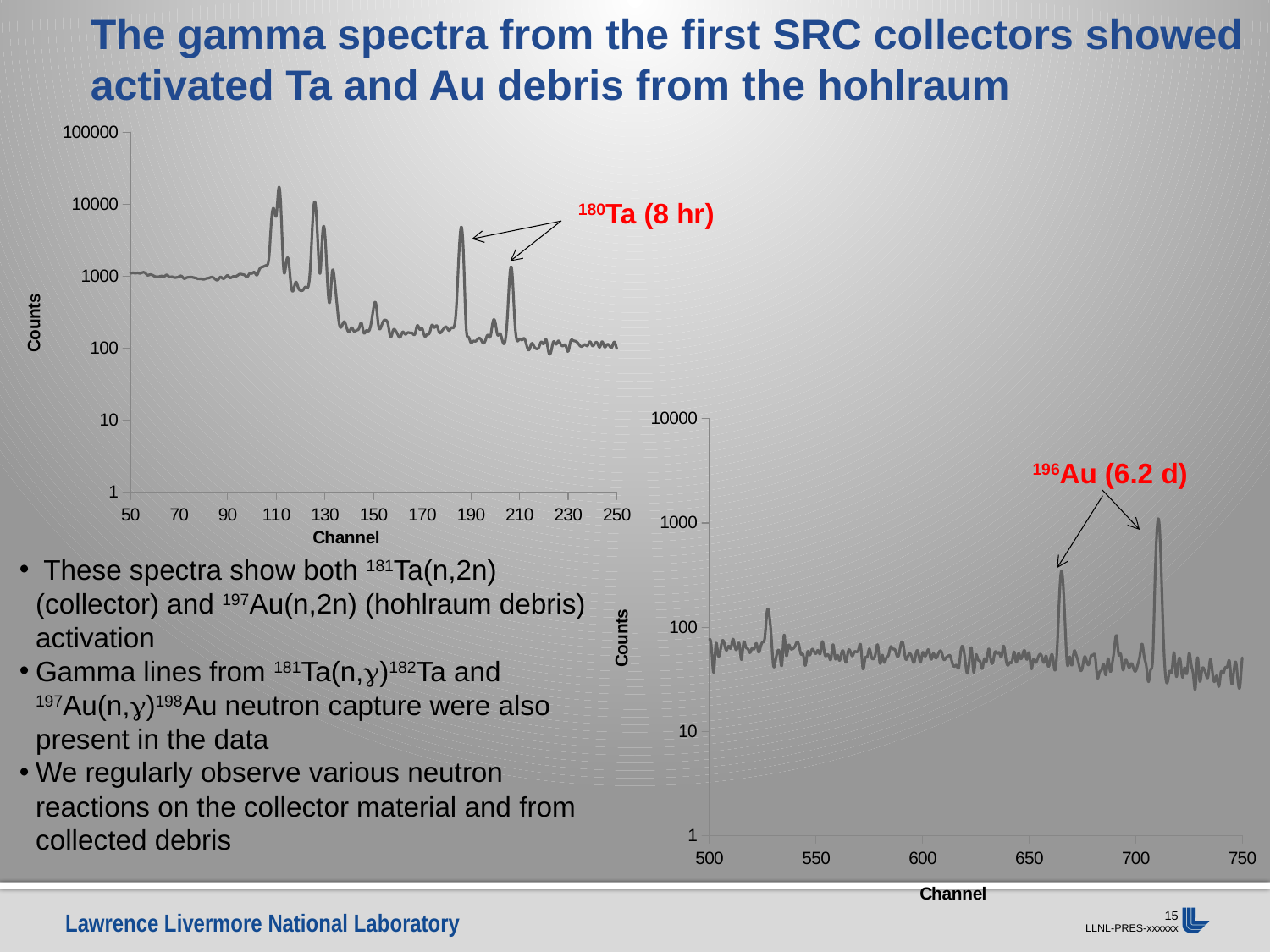
In the left chart, is the value of the peak near channel 190 greater or less than 10000? less In the left chart, what is the label on the y axis? Counts In the right chart, is the value of the peak near channel 665 greater or less than 100? greater In the left chart, is the value of the tallest peak near channel 110 greater or less than 10000? greater In the right chart, which is larger: the peak near channel 665 or the peak near channel 710? the peak near channel 710 In the right chart, what is the label on the x axis? Channel What kind of chart is the right chart (Channel 500 to 750)? line chart What kind of chart is the left chart (Channel 50 to 250)? line chart In the left chart, which is larger: the peak near channel 110 or the peak near channel 190? the peak near channel 110